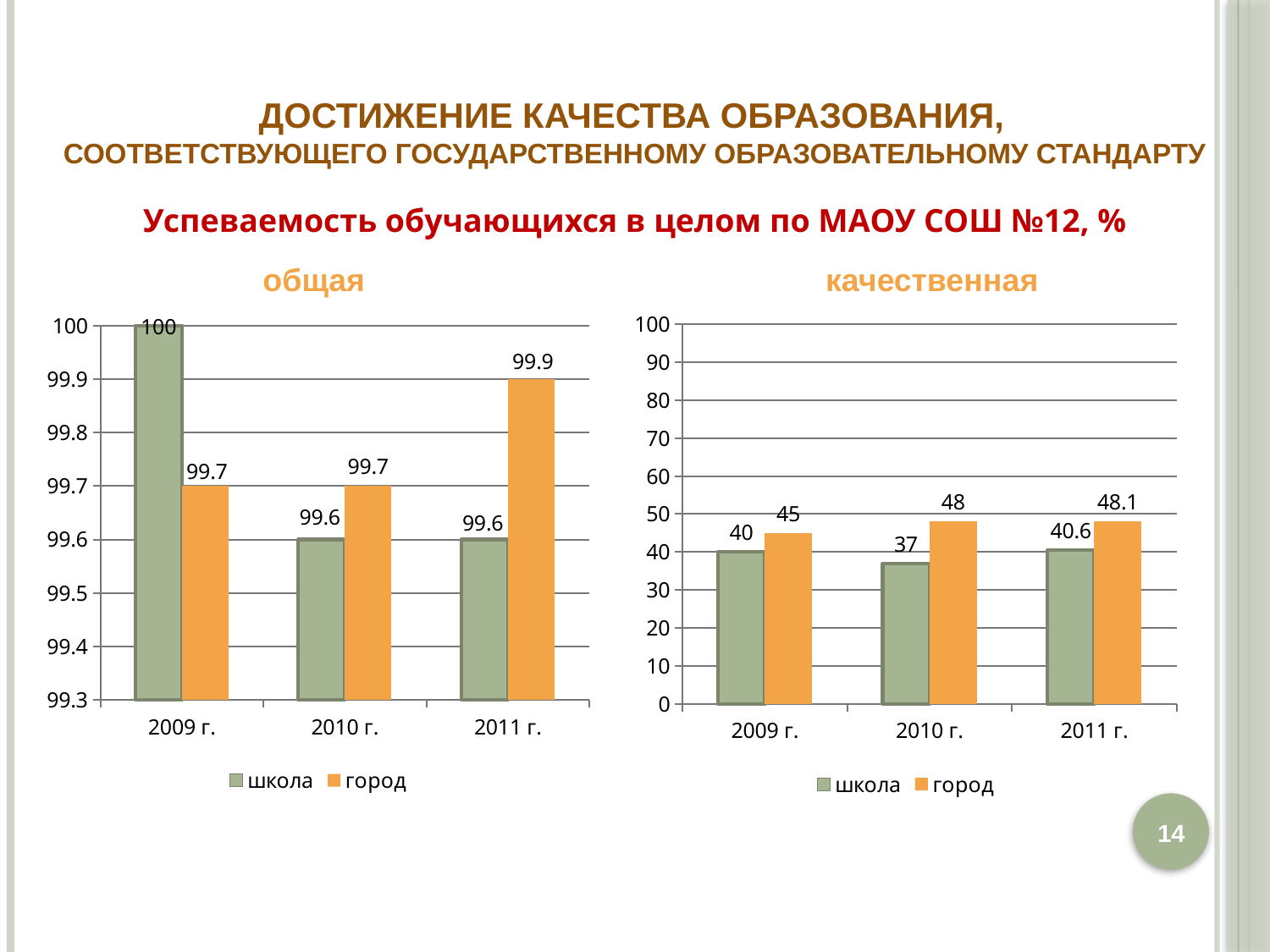
In the 'качественная' chart, is the value for школа in 2011 г. greater or less than 50? less In the 'качественная' chart, which year has the lowest value for школа? 2010 г. In the 'качественная' chart, what is the value for школа in 2010 г.? 37 What kind of chart is the 'качественная' chart? bar chart In the 'качественная' chart, what is the difference between город and школа in 2010 г.? 11 In the 'общая' chart, what is the value for школа in 2009 г.? 100 In the 'общая' chart, which year has the highest value for город? 2011 г. In the 'общая' chart, which is larger in 2009 г., школа or город? школа In the 'общая' chart, what is the value for город in 2011 г.? 99.9 In the 'качественная' chart, what is the value for город in 2011 г.? 48.1 How many years are shown on the x axis of the 'общая' chart? 3 How many series does the legend of the 'качественная' chart list? 2